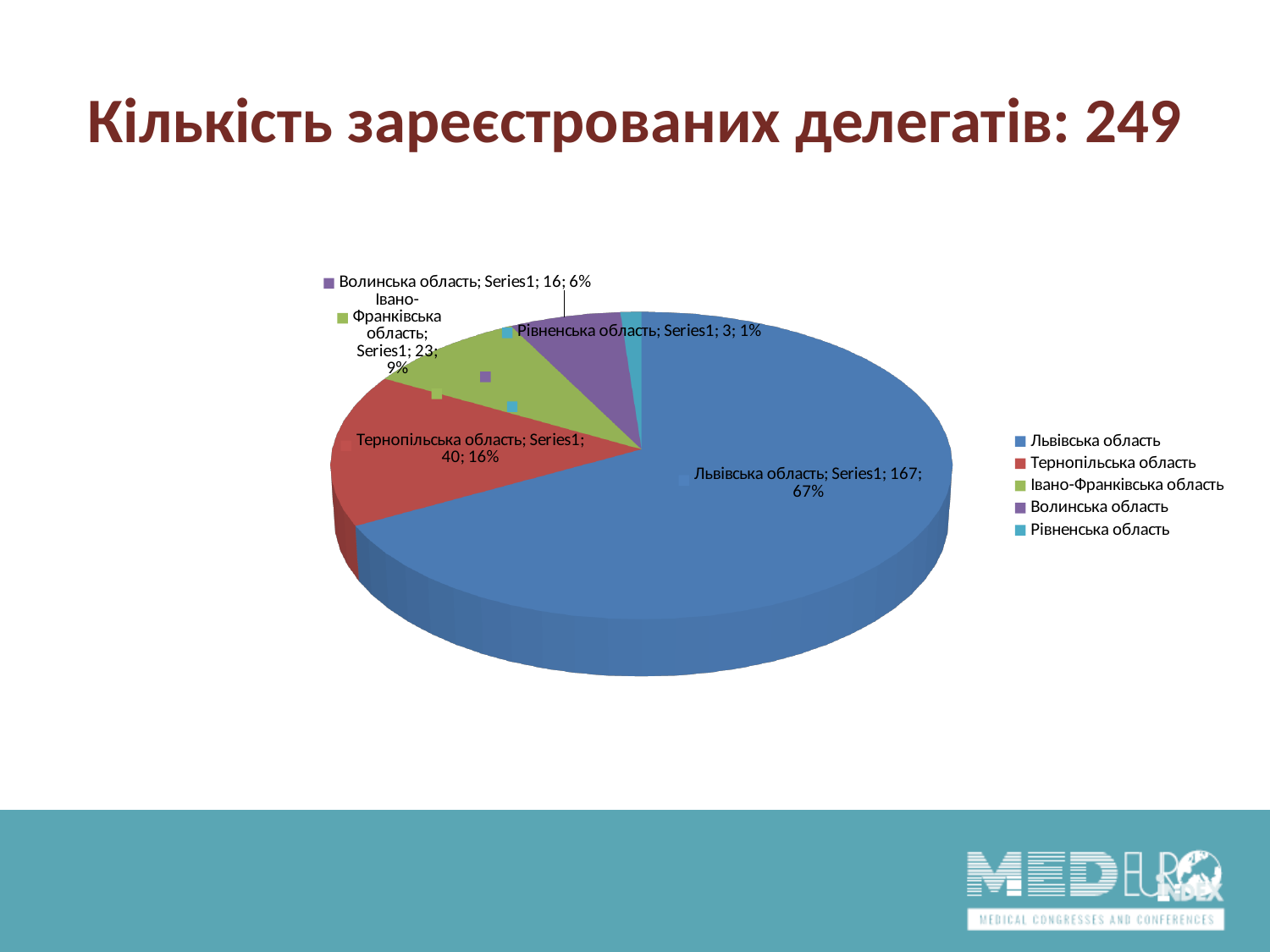
Which region has the smallest slice of the pie? Рівненська область What is the title of the slide? Кількість зареєстрованих делегатів: 249 How many delegates are shown for Івано-Франківська область? 23 Which region has the largest slice of the pie? Львівська область How many delegates are shown for Львівська область? 167 What kind of chart is shown on the slide? pie chart What is the difference between the number of delegates for Львівська область and Тернопільська область? 127 What share of the pie does Волинська область have? 6% How many delegates are shown for Рівненська область? 3 How many regions are shown in the pie chart? 5 Which has more delegates, Волинська область or Івано-Франківська область? Івано-Франківська область What share of the pie does Тернопільська область have? 16%